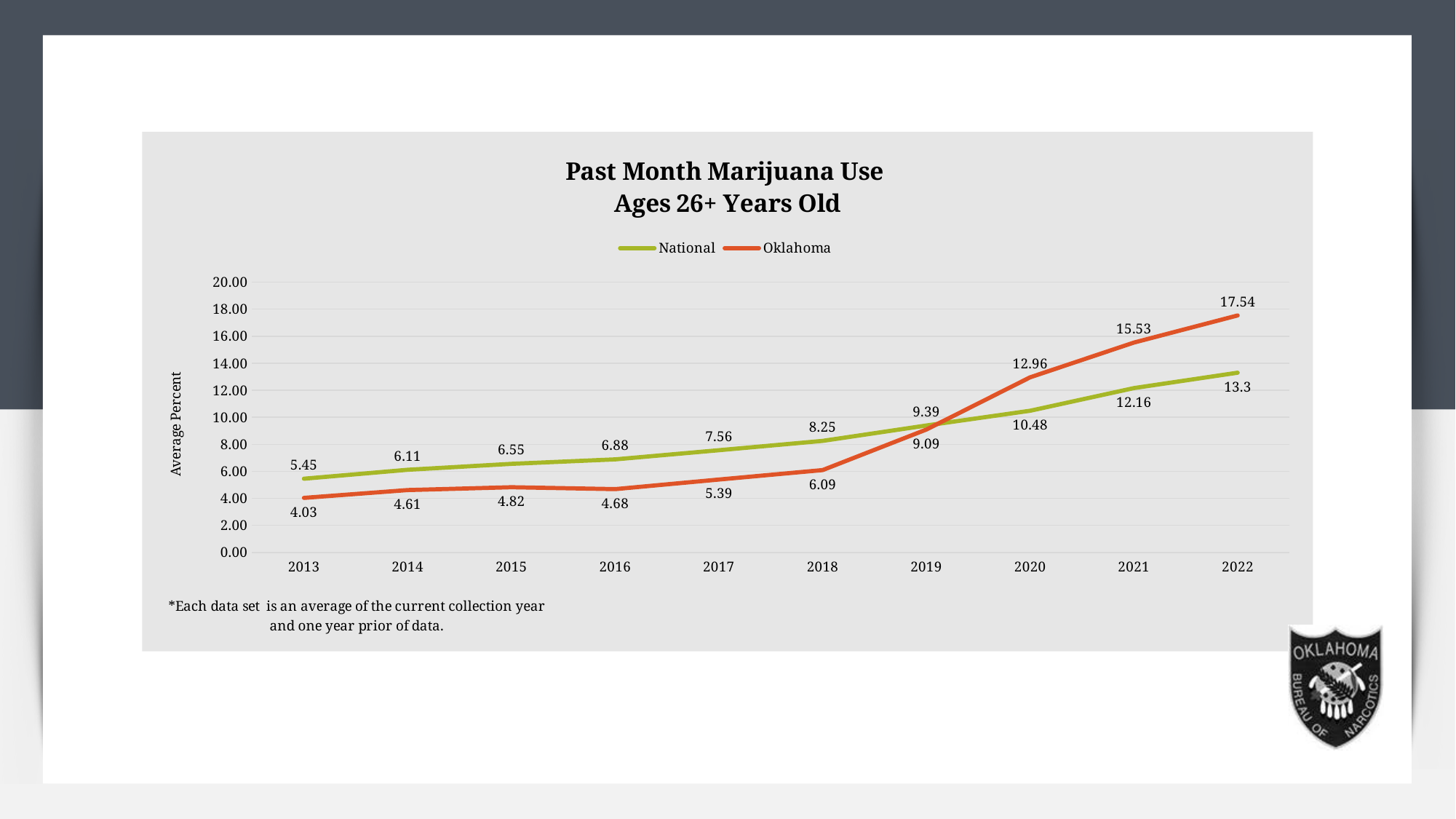
How many years are shown on the x axis? 10 Which is larger in 2017, the National value or the Oklahoma value? National What is the National value for 2020? 10.48 What is the Oklahoma value for 2016? 4.68 What kind of chart is shown on the slide? Line chart In which year is the National value highest? 2022 What is the Oklahoma value for 2022? 17.54 Which is larger in 2021, the National value or the Oklahoma value? Oklahoma In which year is the Oklahoma value lowest? 2013 What is the difference between the Oklahoma and National values in 2022? 4.24 What is the National value for 2013? 5.45 How many series does the legend list? 2